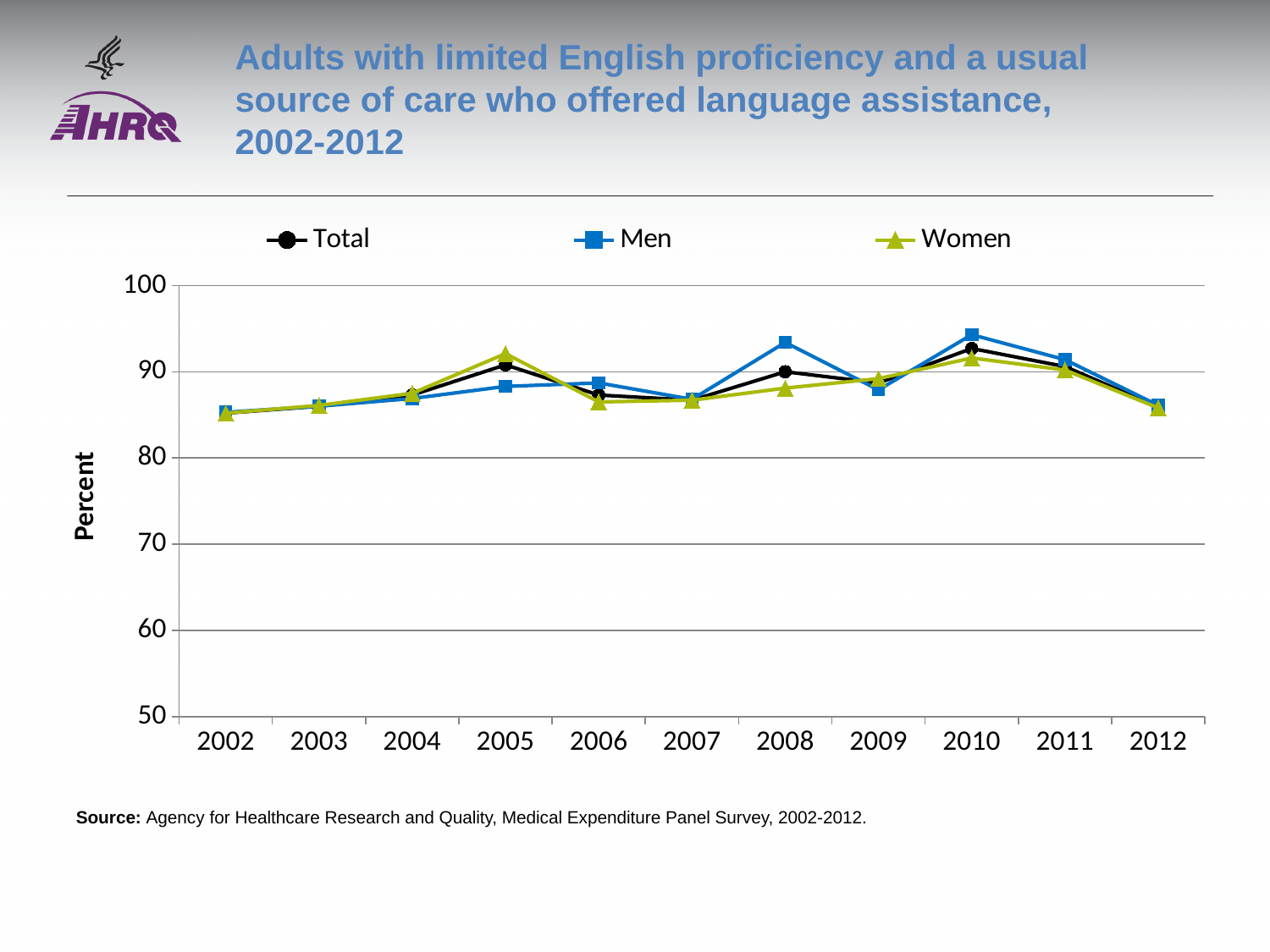
Is the value for Total in 2002 greater or less than 80? greater Does the Total series rise or fall from 2002 to 2005? rise How many series does the legend list? 3 What kind of chart is shown on the slide? line chart What is the label of the y axis? Percent Which series are listed in the legend? Total, Men, Women Is the value for Men in 2008 greater or less than 90? greater Is the value for Women in 2007 greater or less than 90? less How many years are plotted along the x axis? 11 In 2008, which is larger, the value for Men or the value for Women? Men In 2005, which is larger, the value for Men or the value for Women? Women Does the Total series rise or fall from 2010 to 2012? fall